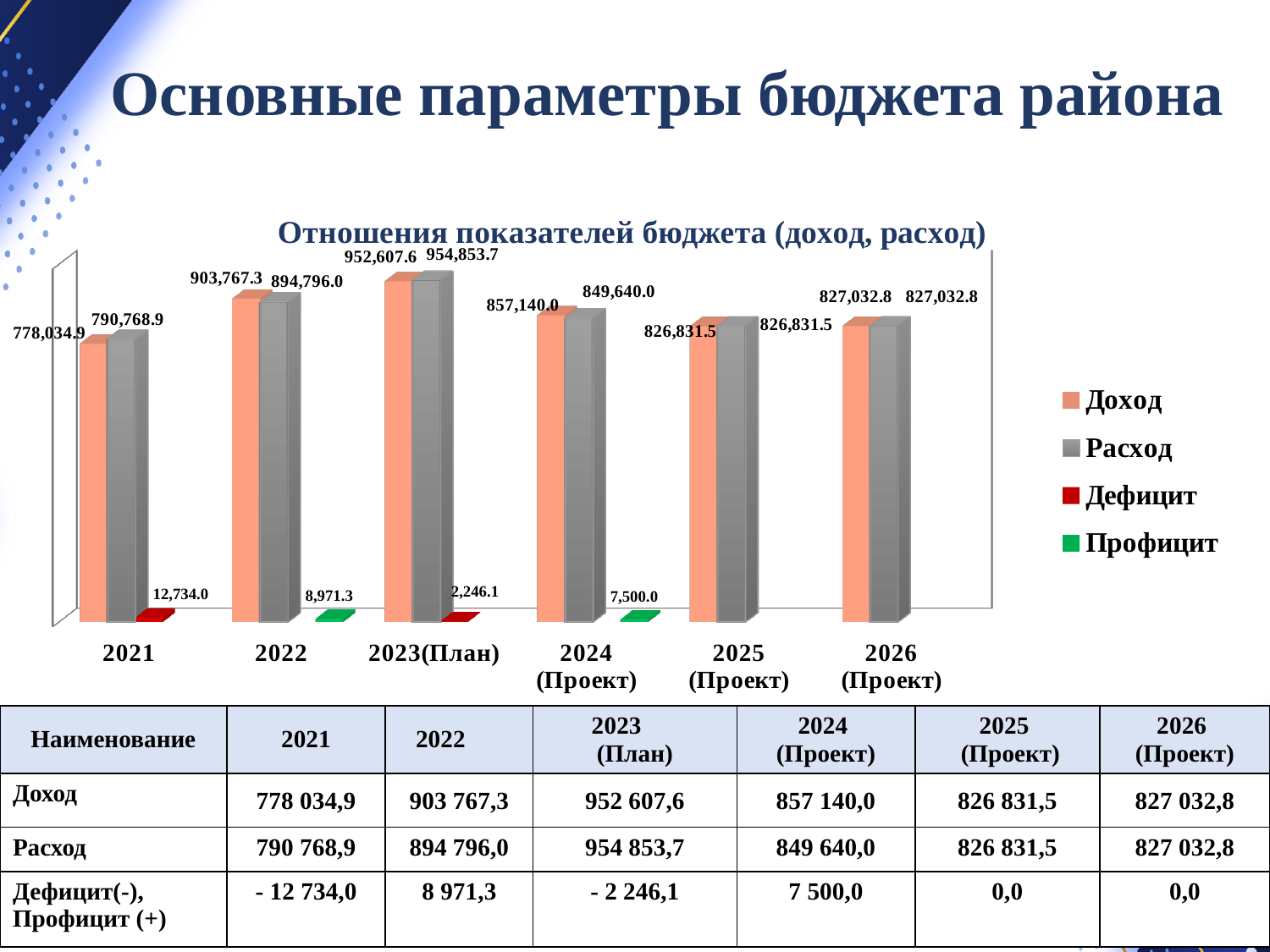
Which year has the highest Доход value in the chart? 2023(План) What is the value of Расход for 2023(План) in the chart? 954,853.7 What is the value of Доход for 2021 in the chart? 778,034.9 What kind of chart is shown on the slide? Bar chart What is the value of Доход for 2024 (Проект) in the chart? 857,140.0 What is the difference between Расход and Доход for 2021 in the chart? 12,734.0 Which year has the lowest Расход value in the chart? 2021 What is the title of the chart on the slide? Отношения показателей бюджета (доход, расход) How many year categories are shown on the x axis of the chart? 6 What is the value of Расход for 2026 (Проект) in the chart? 827,032.8 How many series does the chart legend list? 4 For 2022, which is larger in the chart: Доход or Расход? Доход